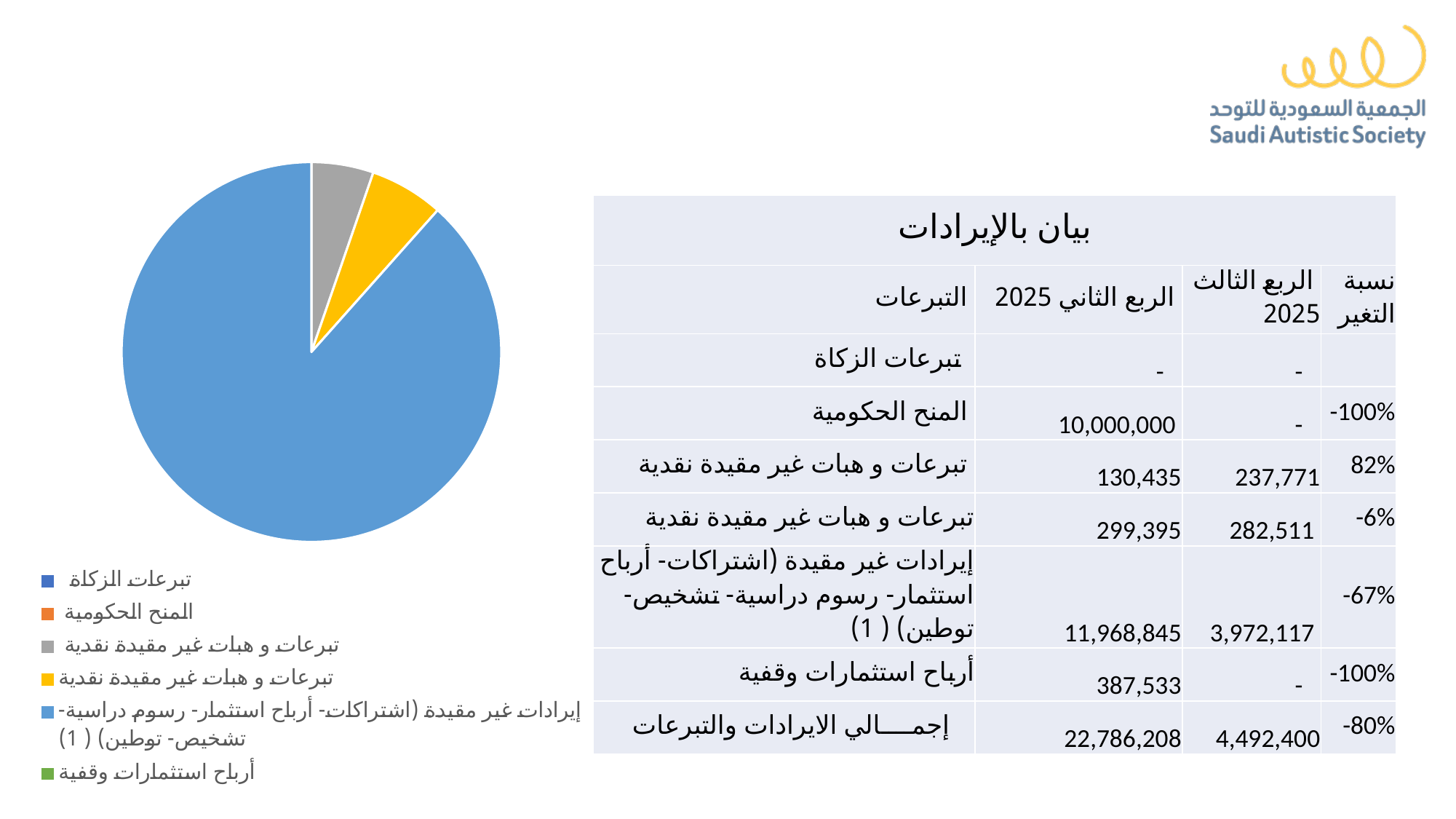
Which legend entry of the pie chart is shown in green? أرباح استثمارات وقفية How many entries does the legend of the pie chart list? 6 Does the pie chart's largest slice take up more or less than half of the pie? more In the pie chart, which slice is larger: the yellow slice or the gray slice? the yellow slice What kind of chart is shown on the left of the slide? pie chart What colour is the largest slice of the pie chart? blue Which category has the largest slice in the pie chart? إيرادات غير مقيدة (اشتراكات- أرباح استثمار- رسوم دراسية- تشخيص- توطين) ( 1 ) How many slices are visibly drawn in the pie chart? 3